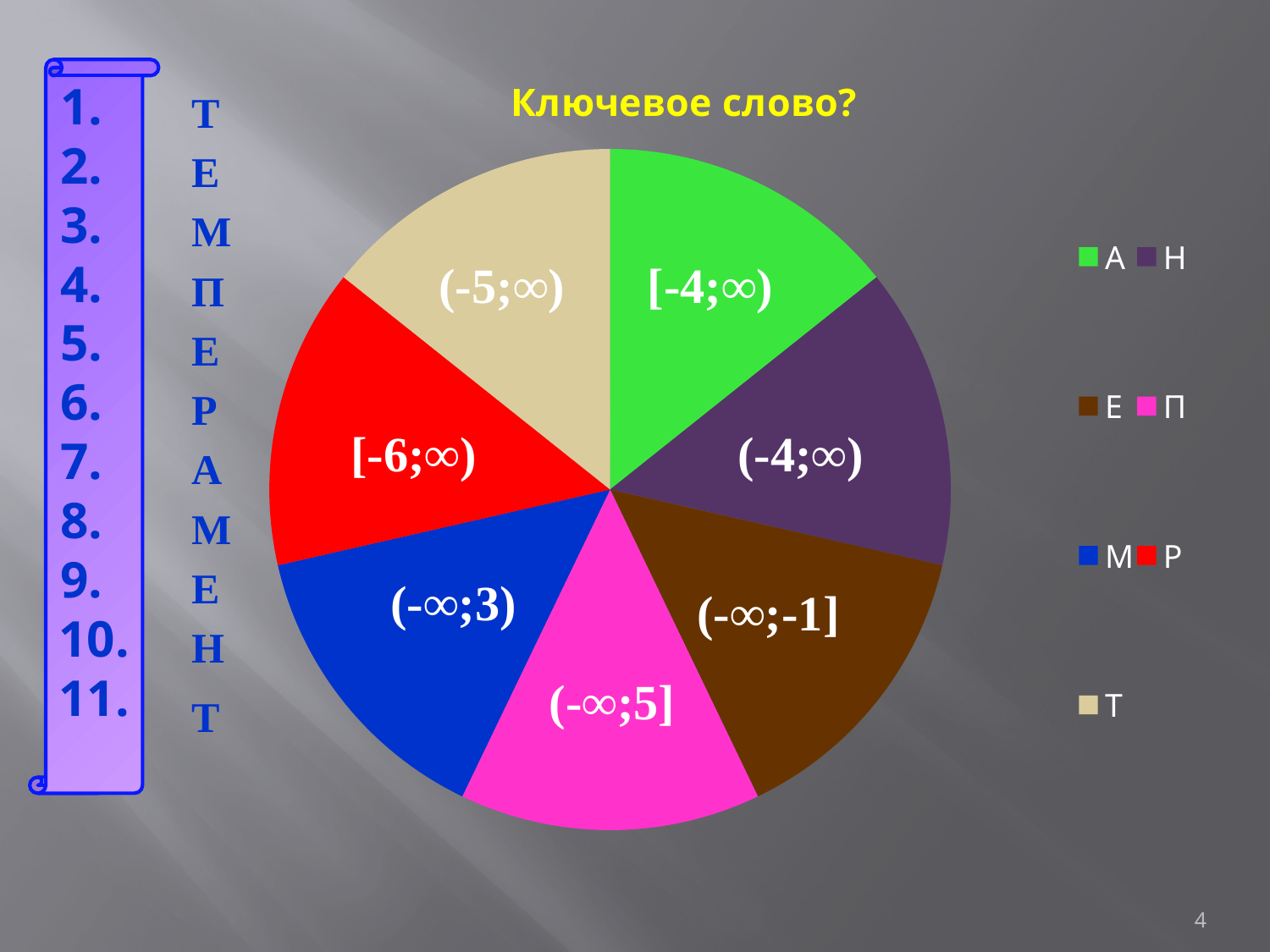
What label is printed on the red slice (Р) of the pie chart? [-6;∞) What colour is the slice for legend entry А in the pie chart? green What label is printed on the beige slice (Т) of the pie chart? (-5;∞) What kind of chart is shown on the slide? pie chart What is the title shown above the pie chart? Ключевое слово? How many entries does the legend of the pie chart list? 7 What label is printed on the purple slice (Н) of the pie chart? (-4;∞) What label is printed on the brown slice (Е) of the pie chart? (-∞;-1] What label is printed on the pink slice (П) of the pie chart? (-∞;5] What label is printed on the blue slice (М) of the pie chart? (-∞;3) What label is printed on the green slice (А) of the pie chart? [-4;∞) How many slices does the pie chart have? 7